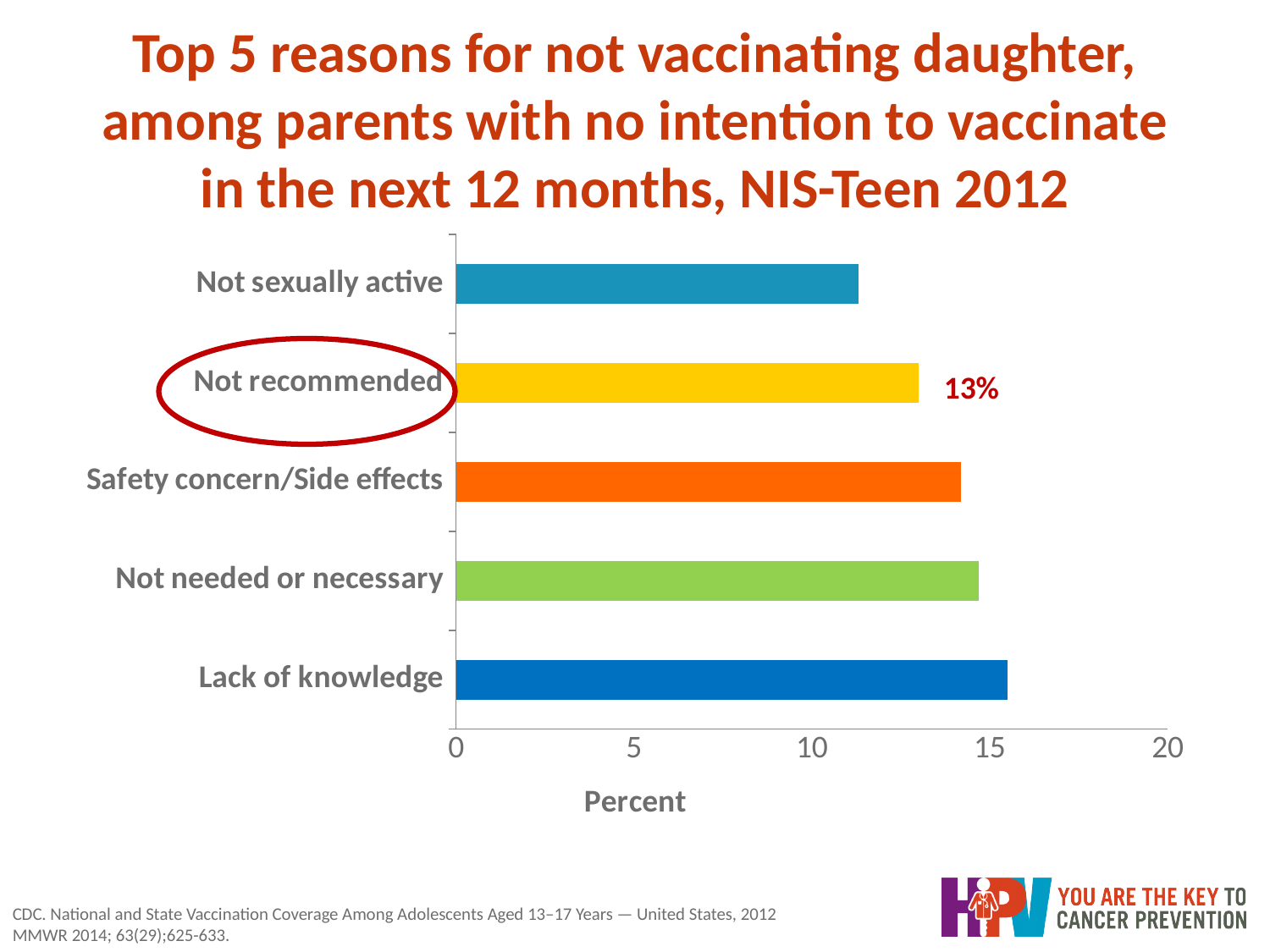
Which reason has the shortest bar? Not sexually active Which is larger, the value for "Not recommended" or the value for "Not sexually active"? Not recommended Is the value for "Not sexually active" greater or less than 10? greater What kind of chart is shown on the slide? bar chart Is the value for "Not sexually active" greater or less than 15? less Is the value for "Safety concern/Side effects" greater or less than 15? less What value is labelled on the bar for "Not recommended"? 13% Which is larger, the value for "Lack of knowledge" or the value for "Not sexually active"? Lack of knowledge How many reasons are shown in the chart? 5 Which reason has the longest bar? Lack of knowledge What is the label on the horizontal axis of the chart? Percent